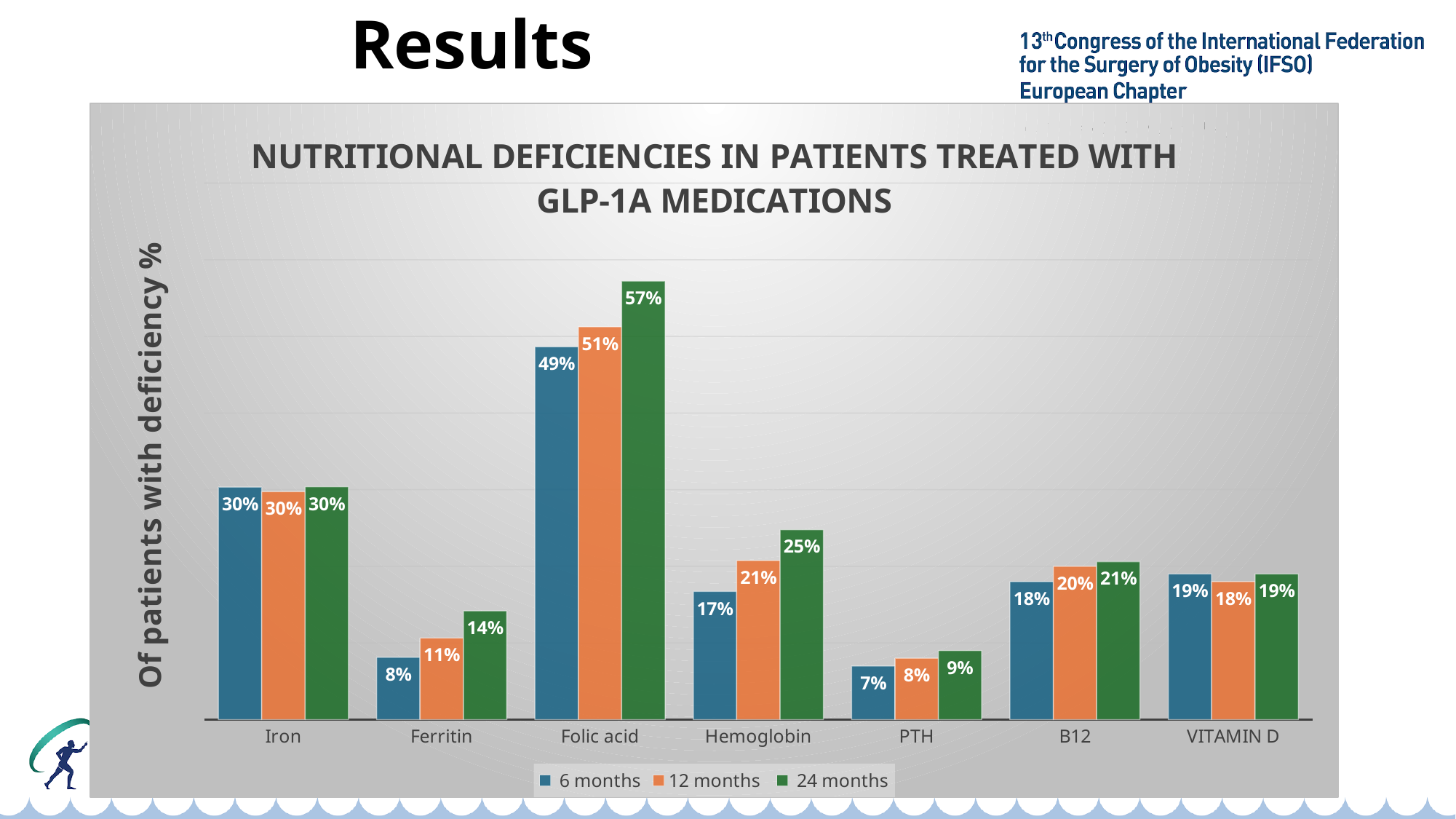
What is the y-axis label of the chart? Of patients with deficiency % What is the value for Folic acid at 24 months? 57% Which category has the lowest value at 24 months? PTH What is the difference between the 24 months and 6 months values for Folic acid? 8% How many categories are shown on the x axis? 7 What is the value for VITAMIN D at 12 months? 18% What is the value for Ferritin at 6 months? 8% How many series does the legend list? 3 Which is larger: the 24 months value for Hemoglobin or the 24 months value for B12? Hemoglobin What kind of chart is shown on the slide? Bar chart Which category has the highest value at 6 months? Folic acid What is the value for Hemoglobin at 12 months? 21%